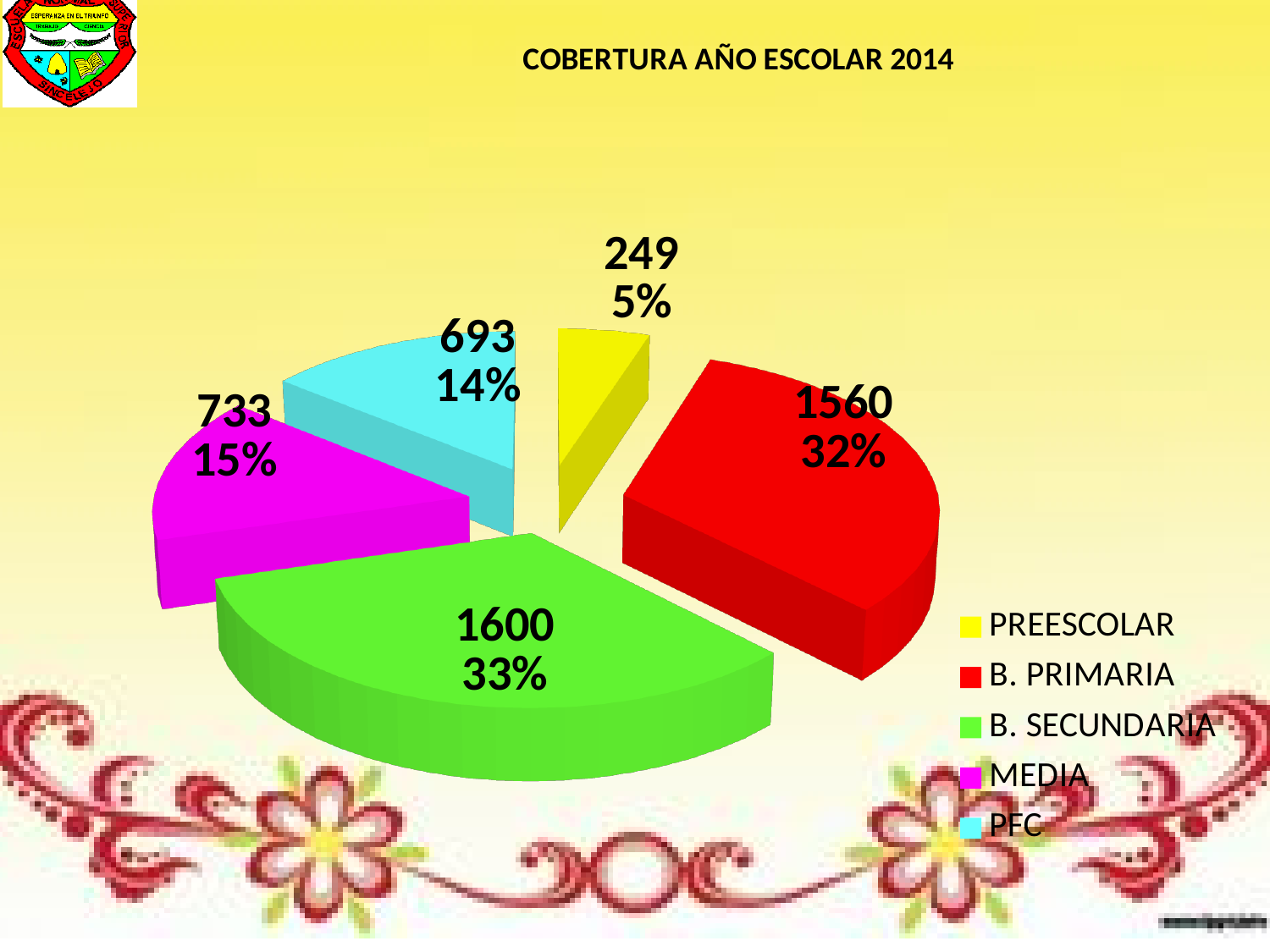
Which category has the largest value? B. SECUNDARIA Which colour represents MEDIA in the legend? Magenta Which category has the smallest value? PREESCOLAR What is the value for B. PRIMARIA? 1560 What is the value for MEDIA? 733 What type of chart is shown on the slide? Pie chart How many slices does the pie chart have? 5 What percentage share of the pie does PREESCOLAR represent? 5% What is the title of the chart? COBERTURA AÑO ESCOLAR 2014 What percentage share of the pie does B. SECUNDARIA represent? 33% What is the difference between the values for B. SECUNDARIA and B. PRIMARIA? 40 What is the value for PFC? 693